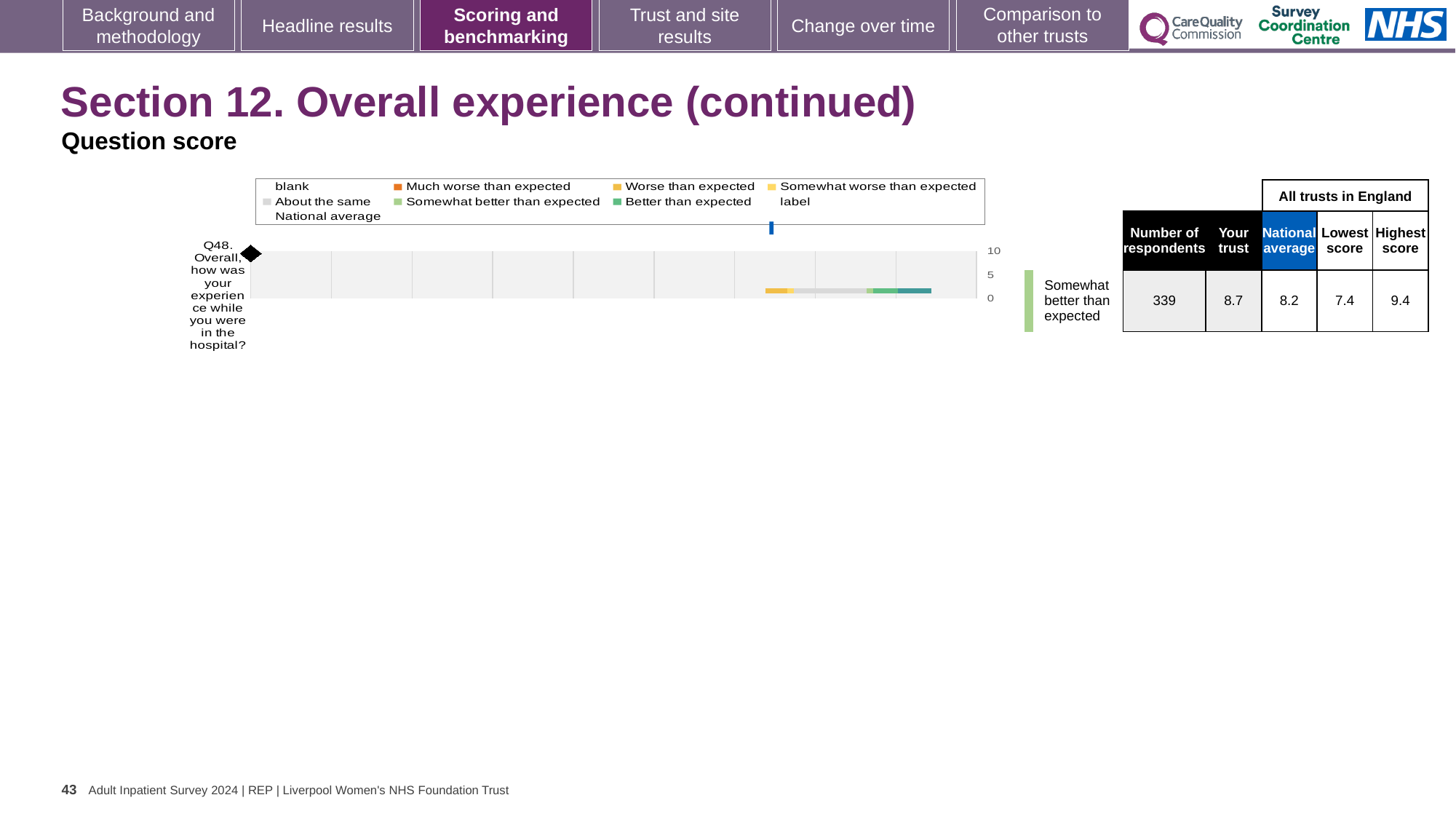
What kind of chart is shown on the slide? bar chart What is the national average score for Q48 shown next to the chart? 8.2 What is the 'Your trust' score for Q48 shown next to the chart? 8.7 How many respondents answered Q48? 339 What is the difference between the highest and lowest scores for Q48 across all trusts in England? 2.0 What is the highest score among all trusts in England for Q48? 9.4 Which benchmarking category is Q48 assigned to on the slide? Somewhat better than expected Which is larger for Q48, the 'Your trust' score or the national average? Your trust How many survey questions are plotted in the chart? 1 What is the maximum value shown on the chart's score axis? 10 What is the difference between the 'Your trust' score and the national average for Q48? 0.5 What is the lowest score among all trusts in England for Q48? 7.4